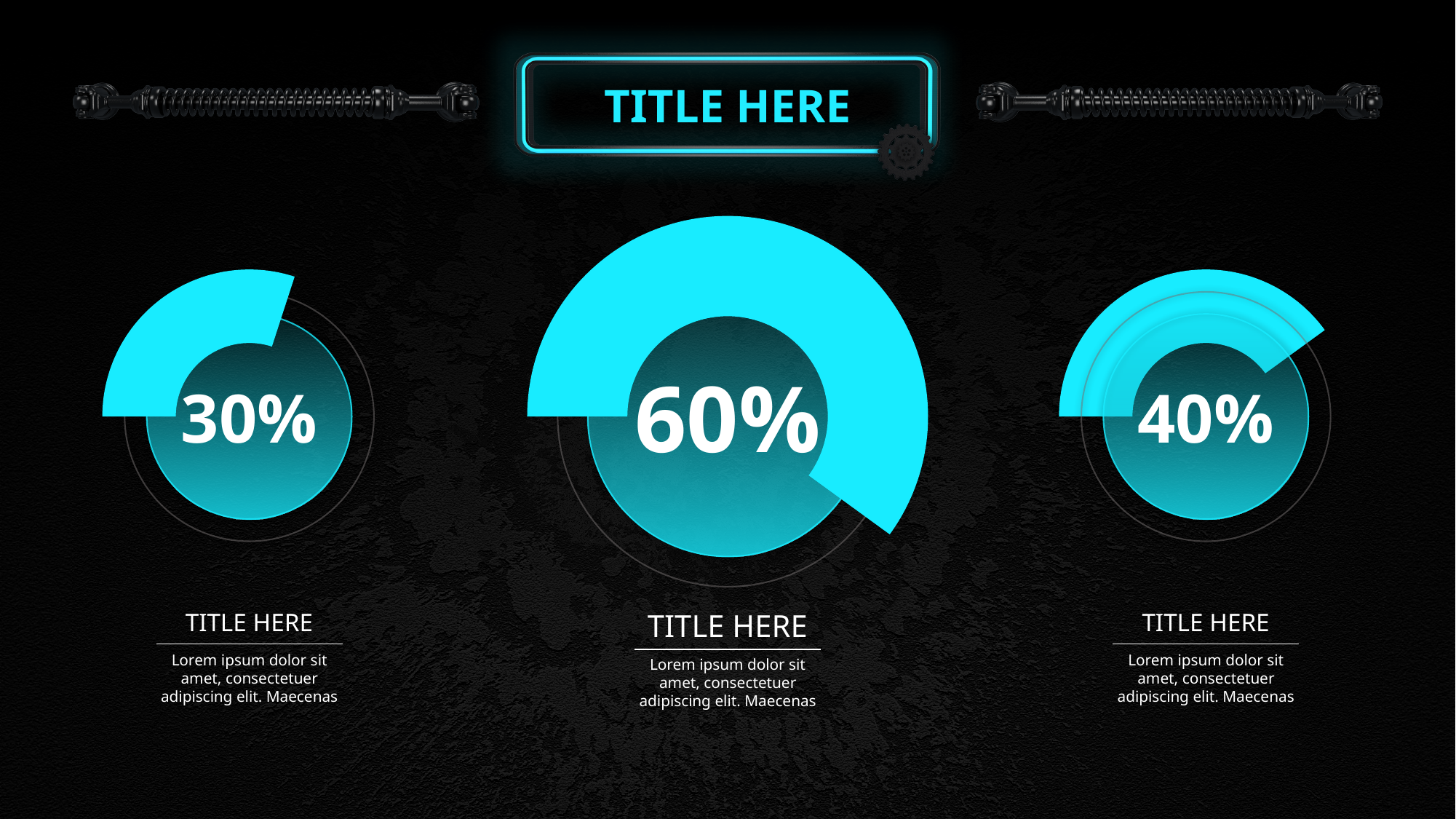
How many percentage charts are on the slide? 3 What is the difference between the percentage in the middle chart and the percentage in the left chart? 30% What kind of chart is used to show the percentages on the slide? Donut (ring) chart What percentage is shown in the right chart? 40% What percentage is shown in the middle chart? 60% What colour is the filled portion of each donut chart? Cyan Which is larger, the percentage in the right chart or the percentage in the left chart? The right chart (40%) Which of the three charts shows the highest percentage? The middle chart (60%) What percentage is shown in the left chart? 30% What is the difference between the percentage in the right chart and the percentage in the left chart? 10% Is the percentage in the middle chart greater or less than 50%? greater Which of the three charts shows the lowest percentage? The left chart (30%)